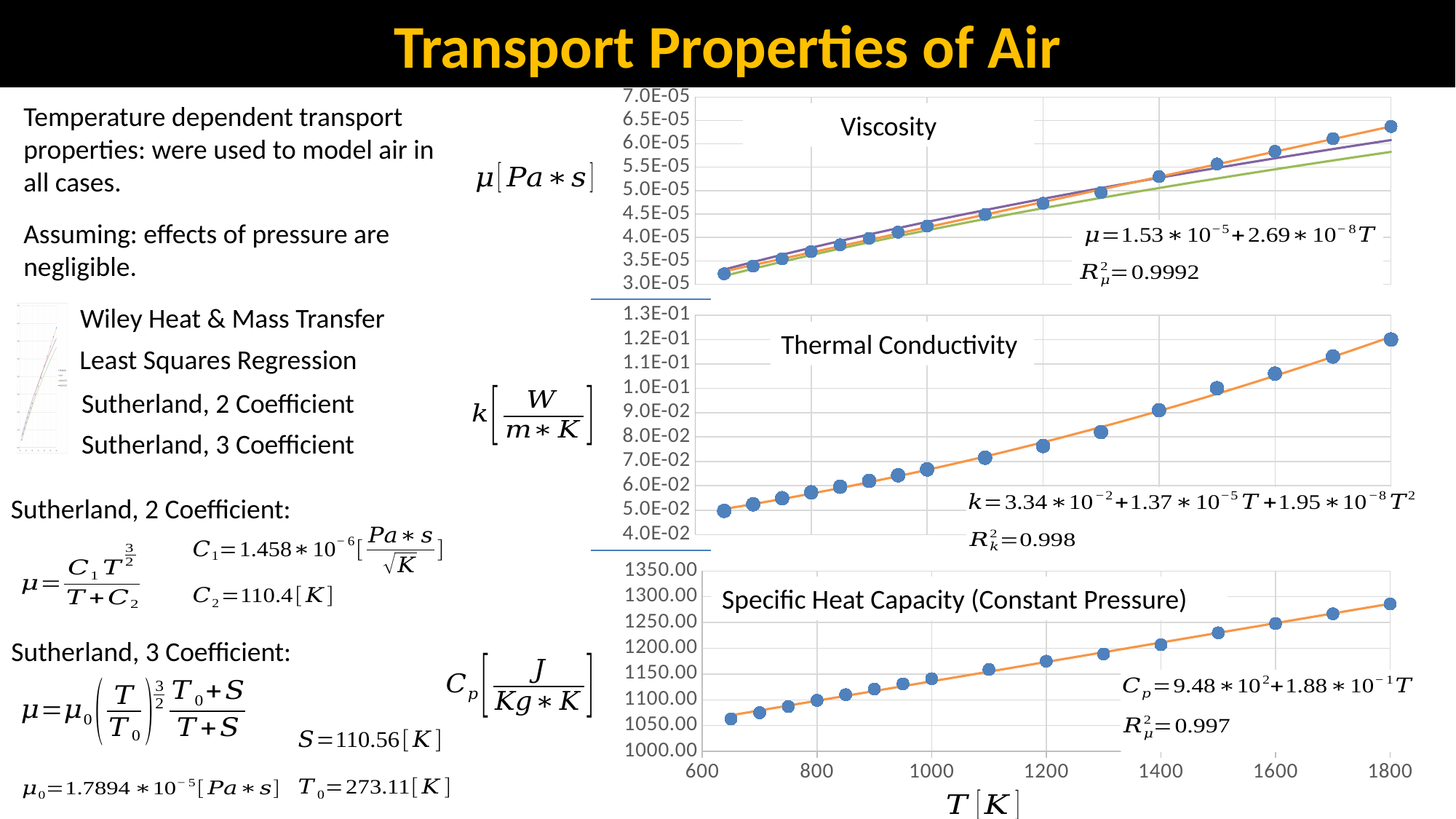
In the Thermal Conductivity chart, do the plotted values rise or fall as temperature increases? rise In the Thermal Conductivity chart, is the value at T = 1200 K greater or less than 8.0E-02? less In the Specific Heat Capacity chart, is the value at T = 1800 K greater or less than 1250.00? greater In the Viscosity chart, is the value at T = 650 K greater or less than 3.5E-05? less What is the title of the bottom chart? Specific Heat Capacity (Constant Pressure) In the Specific Heat Capacity chart, do the values rise or fall as temperature increases? rise In the Thermal Conductivity chart, which temperature has the highest plotted value? 1800 In the Viscosity chart, do the plotted values rise or fall as temperature increases along the x axis? rise What is the title of the top chart? Viscosity